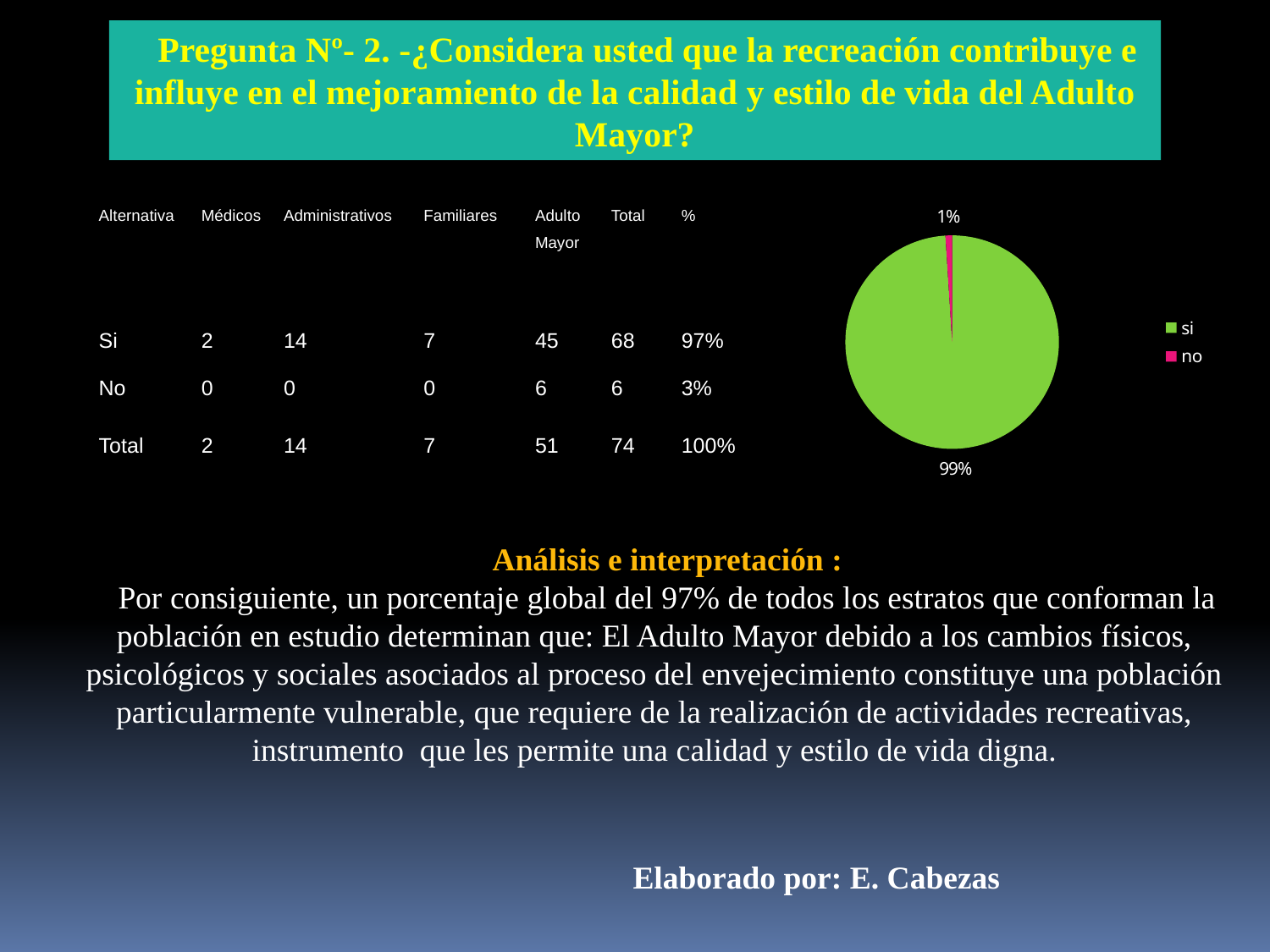
Is the 'si' slice of the pie chart greater or less than 50%? greater What are the two entries listed in the legend of the pie chart? si, no Which slice of the pie chart is the largest? si What kind of chart is shown on the slide? pie chart What colour is the 'si' slice in the pie chart? green Which slice of the pie chart is the smallest? no What percentage label is shown on the 'no' slice of the pie chart? 1% What percentage label is shown on the 'si' slice of the pie chart? 99% How many slices does the pie chart have? 2 What is the difference between the 'si' and 'no' percentages shown on the pie chart? 98% How many entries does the legend of the pie chart list? 2 Which is larger in the pie chart, the 'si' slice or the 'no' slice? si